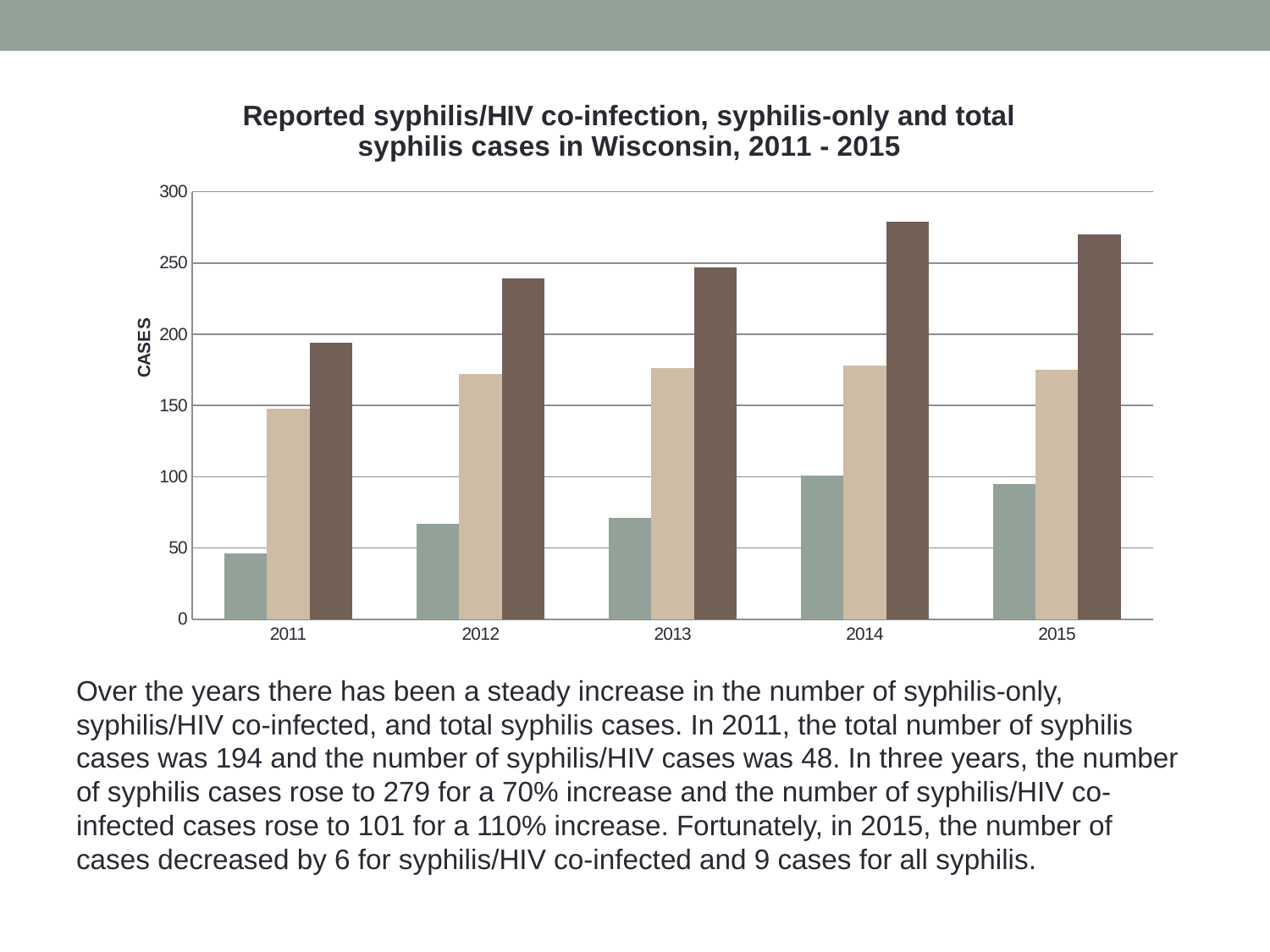
Is the value of the dark brown bar for 2014 greater or less than 250? greater What is the label on the y axis of the chart? CASES How many years are shown on the x axis of the chart? 5 In which year is the dark brown bar the tallest? 2014 In which year is the green bar the shortest? 2011 What is the title of the chart? Reported syphilis/HIV co-infection, syphilis-only and total syphilis cases in Wisconsin, 2011 - 2015 Is the value of the green bar for 2011 greater or less than 50? less Is the value of the dark brown bar for 2011 greater or less than 200? less What kind of chart is shown on the slide? bar chart Which year has the taller dark brown bar, 2011 or 2012? 2012 Do the green bars rise or fall from 2011 to 2014? rise